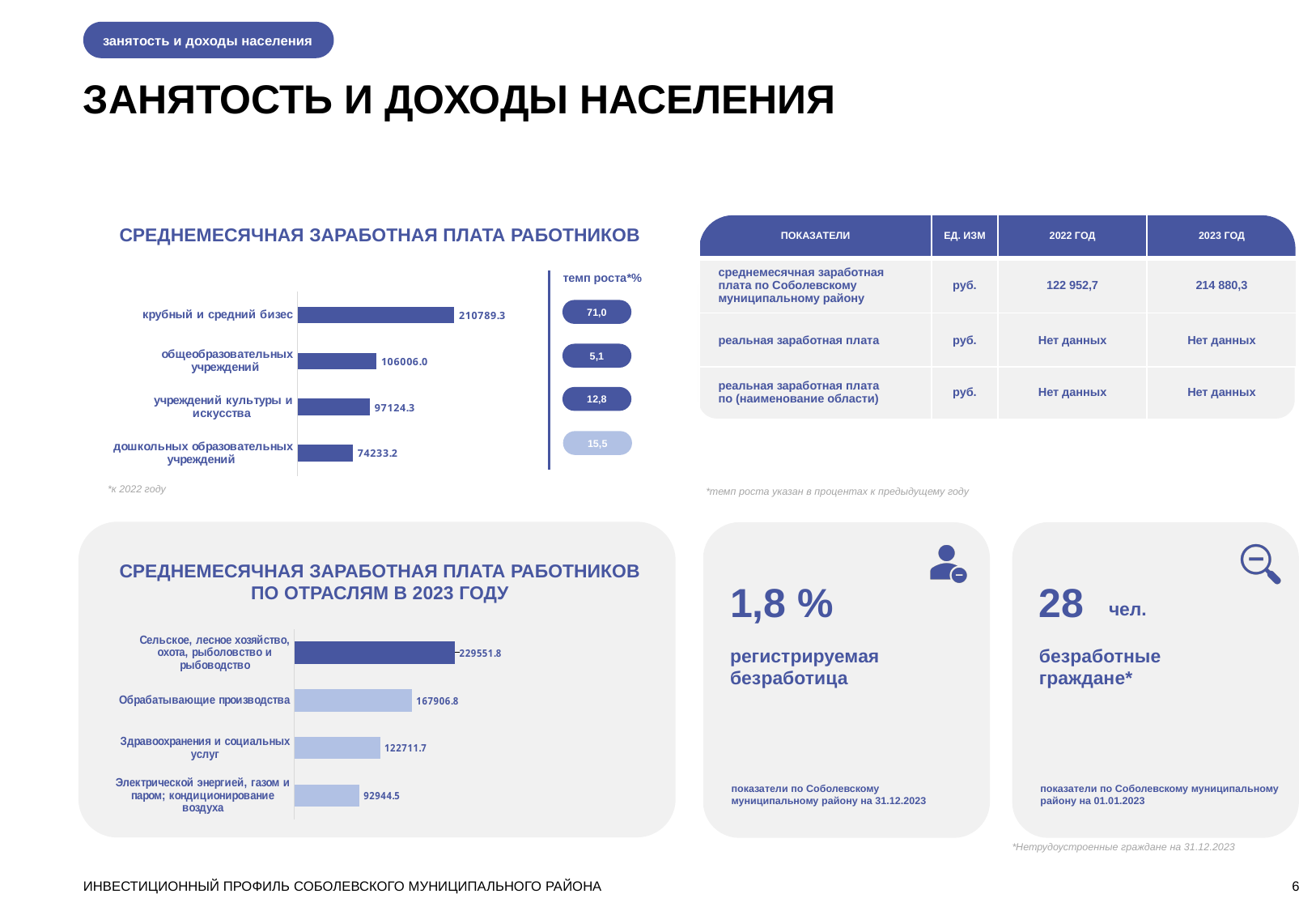
In the chart 'Среднемесячная заработная плата работников по отраслям в 2023 году' (bottom left), which category has the highest value? Сельское, лесное хозяйство, охота, рыболовство и рыбоводство In the chart 'Среднемесячная заработная плата работников по отраслям в 2023 году' (bottom left), what is the difference between 'Сельское, лесное хозяйство, охота, рыболовство и рыбоводство' and 'Обрабатывающие производства'? 61645.0 What type of chart is 'Среднемесячная заработная плата работников по отраслям в 2023 году' (bottom left)? bar chart In the chart 'Среднемесячная заработная плата работников' (top left), what is the value for 'крубный и средний бизес'? 210789.3 In the chart 'Среднемесячная заработная плата работников по отраслям в 2023 году' (bottom left), which is larger: 'Здравоохранения и социальных услуг' or 'Электрической энергией, газом и паром; кондиционирование воздуха'? Здравоохранения и социальных услуг How many categories are shown in the chart 'Среднемесячная заработная плата работников' (top left)? 4 In the chart 'Среднемесячная заработная плата работников' (top left), what is the difference between 'общеобразовательных учреждений' and 'учреждений культуры и искусства'? 8881.7 In the chart 'Среднемесячная заработная плата работников по отраслям в 2023 году' (bottom left), what is the value for 'Обрабатывающие производства'? 167906.8 In the chart 'Среднемесячная заработная плата работников' (top left), which category has the lowest value? дошкольных образовательных учреждений In the chart 'Среднемесячная заработная плата работников' (top left), what is the 'темп роста' value shown next to 'крубный и средний бизес'? 71,0 In the chart 'Среднемесячная заработная плата работников по отраслям в 2023 году' (bottom left), do the values rise or fall from the top bar to the bottom bar? fall In the chart 'Среднемесячная заработная плата работников' (top left), what is the value for 'дошкольных образовательных учреждений'? 74233.2